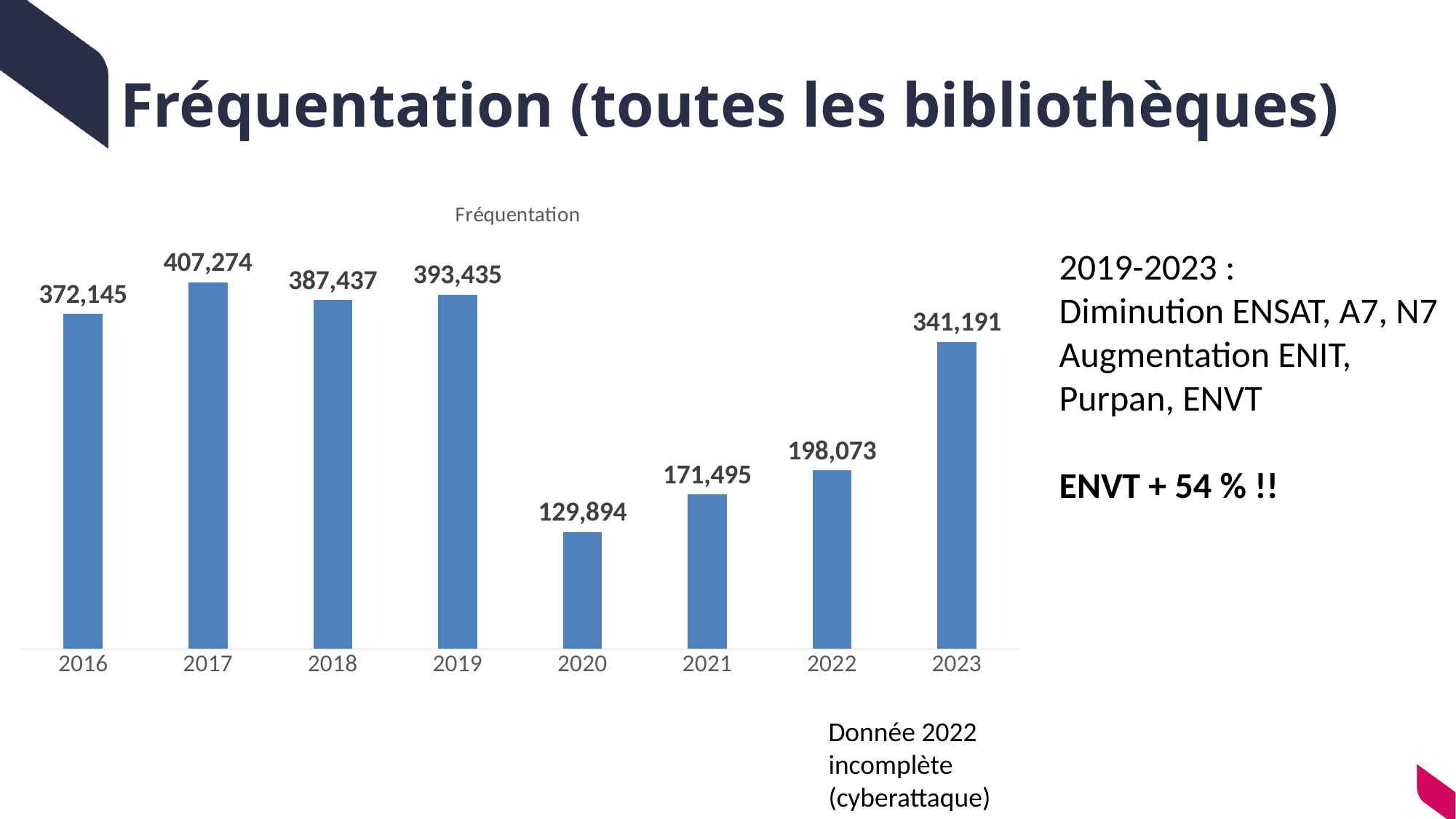
Which year has a larger Fréquentation value, 2018 or 2021? 2018 How many years are shown on the chart? 8 What is the Fréquentation value for 2023? 341,191 What is the difference between the Fréquentation values for 2019 and 2020? 263,541 What kind of chart is shown on the slide? Bar chart What is the Fréquentation value for 2016? 372,145 What is the difference between the Fréquentation values for 2023 and 2022? 143,118 Which year has the highest Fréquentation? 2017 What is the title of the chart? Fréquentation Does the Fréquentation value rise or fall from 2020 to 2023? Rise Which year has the lowest Fréquentation? 2020 What is the Fréquentation value for 2020? 129,894